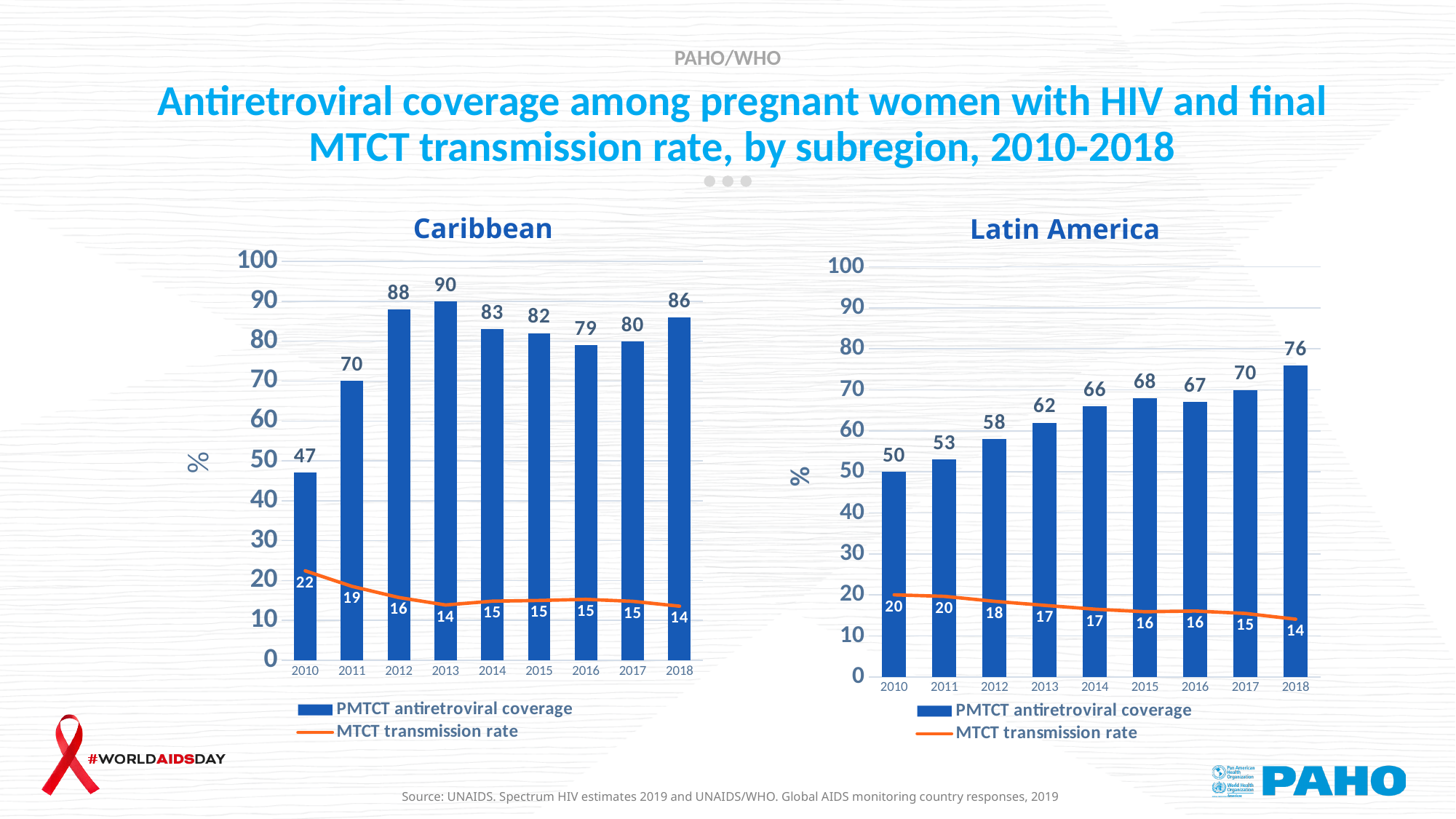
In the Caribbean chart, what is the PMTCT antiretroviral coverage in 2013? 90 Is the PMTCT antiretroviral coverage in 2018 higher in the Caribbean chart or the Latin America chart? Caribbean What kind of chart is used for PMTCT antiretroviral coverage in the Caribbean chart? Bar chart In the Caribbean chart, what colour is the MTCT transmission rate line? Orange How many years are shown on the x axis of the Latin America chart? 9 In the Caribbean chart, which year has the lowest PMTCT antiretroviral coverage? 2010 In the Latin America chart, what is the MTCT transmission rate in 2012? 18 In the Latin America chart, what is the difference in MTCT transmission rate between 2010 and 2018? 6 In the Latin America chart, which year has the highest PMTCT antiretroviral coverage? 2018 How many series does the legend of the Caribbean chart list? 2 In the Caribbean chart, what is the difference in PMTCT antiretroviral coverage between 2011 and 2010? 23 In the Latin America chart, does the MTCT transmission rate rise or fall from 2010 to 2018? Fall